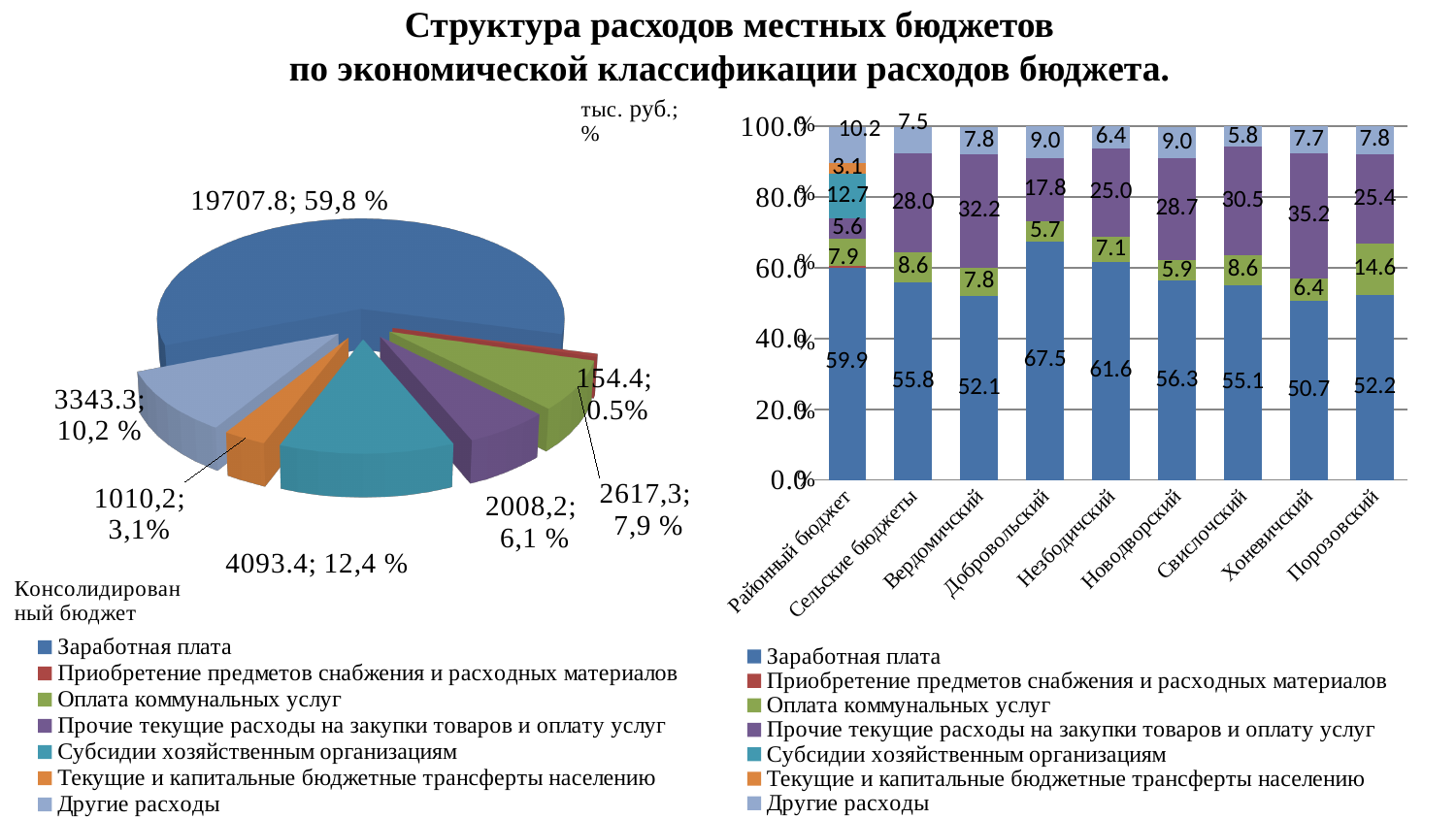
In the right bar chart, what is the value of Заработная плата for Добровольский? 67.5 In the left pie chart, which category has the smallest slice? Приобретение предметов снабжения и расходных материалов In the right bar chart, which category has the highest value for Заработная плата? Добровольский How many series does the legend of the right bar chart list? 7 What type of chart is the right chart on the slide? stacked bar chart In the right bar chart, which is larger: the Прочие текущие расходы value for Хоневичский or for Добровольский? Хоневичский What type of chart is the left chart on the slide? pie chart In the right bar chart, which category has the lowest value for Заработная плата? Хоневичский In the right bar chart, how many categories are shown on the x axis? 9 In the left pie chart, what share does Субсидии хозяйственным организациям have? 12,4 % In the left pie chart, what value and share are shown for Заработная плата? 19707.8; 59,8 % In the left pie chart, what is the difference between the values for Другие расходы (3343.3) and Оплата коммунальных услуг (2617,3)? 726.0